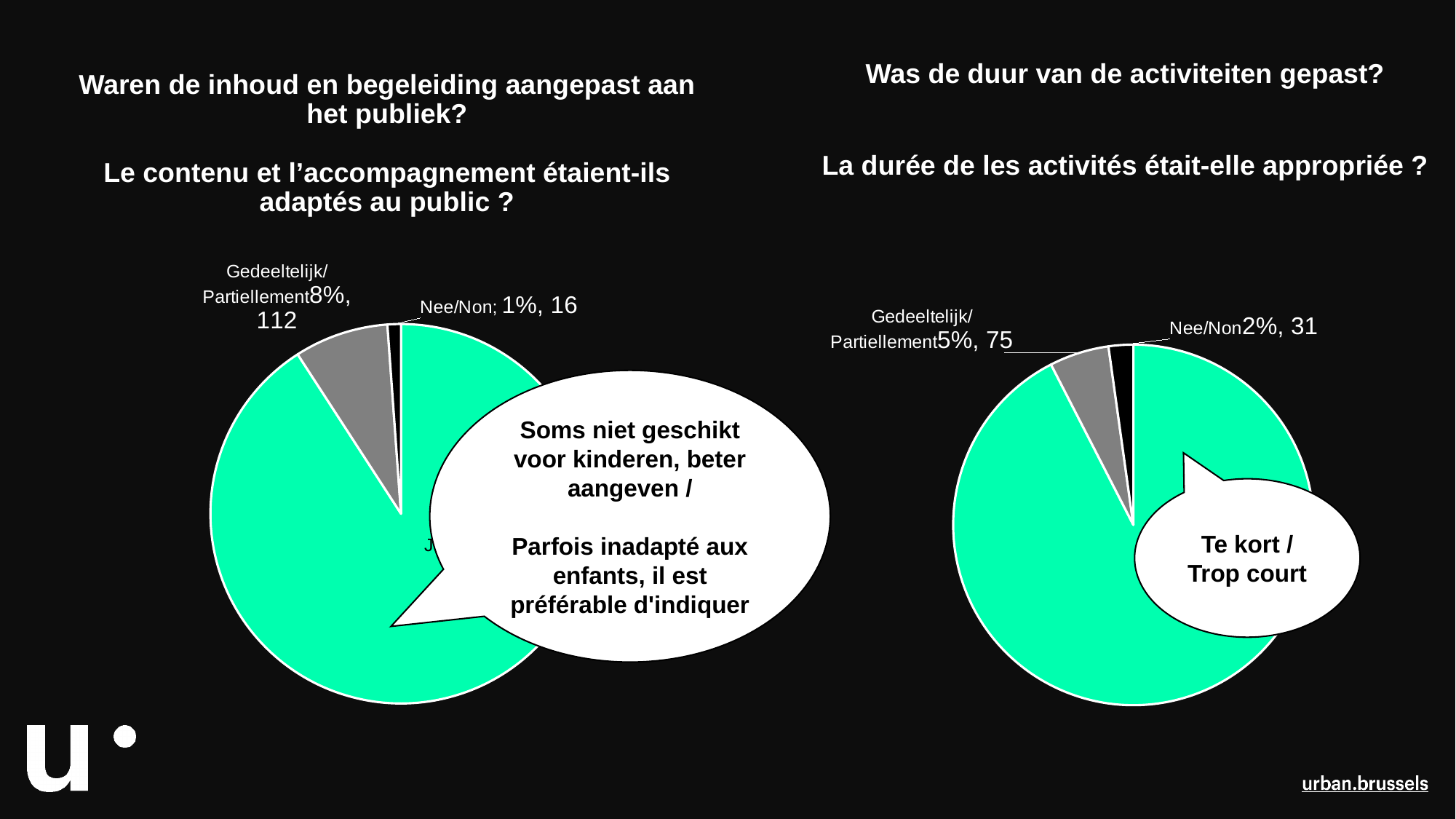
What kind of chart is used on the left side of the slide, under the title 'Waren de inhoud en begeleiding aangepast aan het publiek?'? pie chart In the left pie chart ('Waren de inhoud en begeleiding aangepast aan het publiek?'), what is the difference between the Gedeeltelijk/Partiellement count and the Nee/Non count? 96 In the left pie chart ('Waren de inhoud en begeleiding aangepast aan het publiek?'), what percentage is shown for Nee/Non? 1% In the left pie chart ('Waren de inhoud en begeleiding aangepast aan het publiek?'), which labelled slice is the smallest? Nee/Non In the right pie chart ('Was de duur van de activiteiten gepast?'), how many responses are labelled for Nee/Non? 31 How many pie charts are shown on the slide? 2 In the right pie chart ('Was de duur van de activiteiten gepast?'), what percentage is shown for Gedeeltelijk/Partiellement? 5% In the left pie chart ('Waren de inhoud en begeleiding aangepast aan het publiek?'), how many responses are labelled for Gedeeltelijk/Partiellement? 112 In the right pie chart ('Was de duur van de activiteiten gepast?'), which is larger: the Gedeeltelijk/Partiellement count or the Nee/Non count? Gedeeltelijk/Partiellement In the right pie chart ('Was de duur van de activiteiten gepast?'), what text is written in the speech bubble next to the chart? Te kort / Trop court In the left pie chart ('Waren de inhoud en begeleiding aangepast aan het publiek?'), how many responses are labelled for Nee/Non? 16 In the right pie chart ('Was de duur van de activiteiten gepast?'), what is the difference between the Gedeeltelijk/Partiellement count (75) and the Nee/Non count (31)? 44